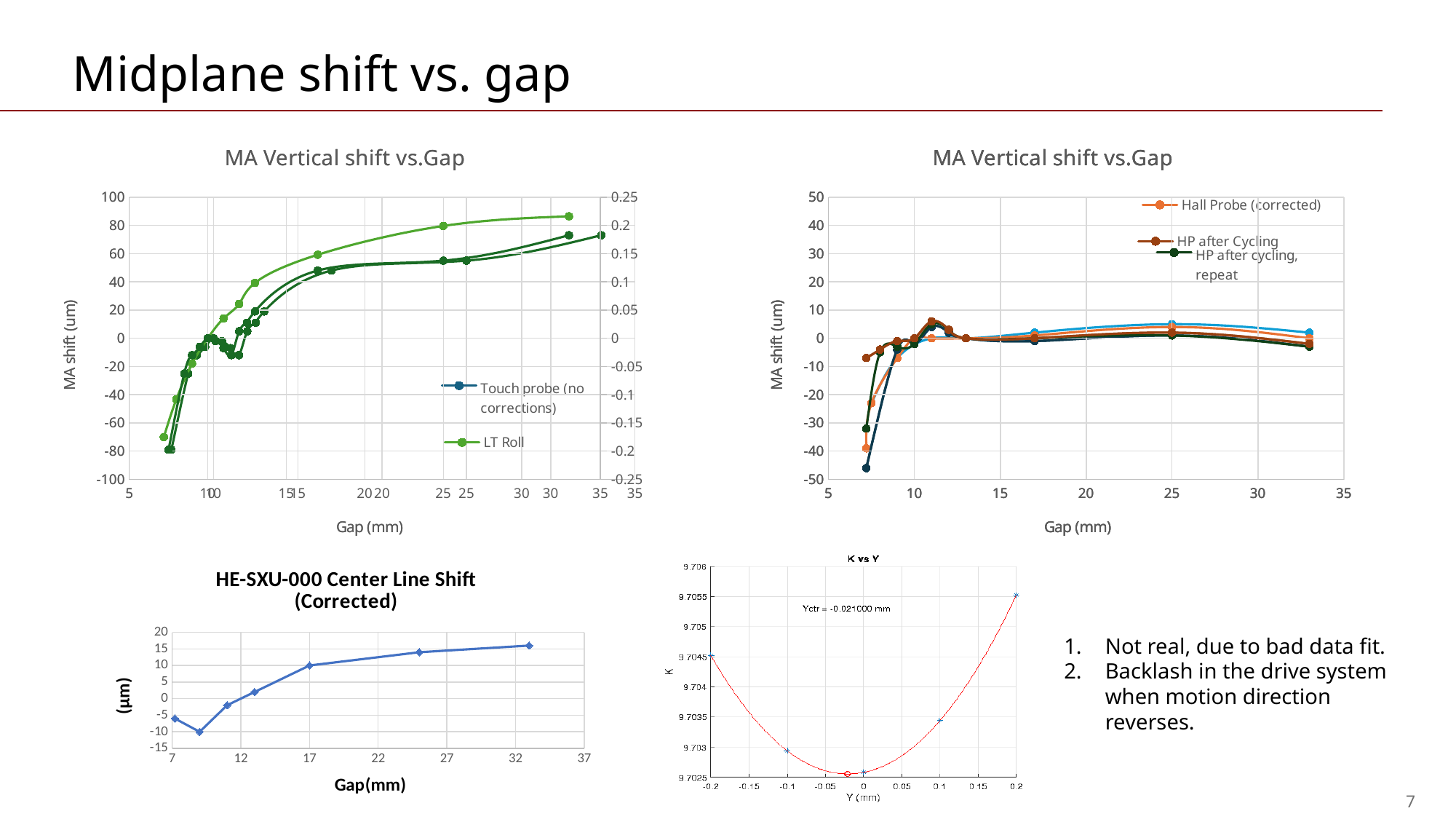
On the top-left MA Vertical shift vs.Gap chart, is the Touch probe (no corrections) value at a gap of 35 mm greater or less than 60 on the left axis? greater What is the Yctr value printed on the K vs Y chart? -0.021000 mm Which series on the top-left MA Vertical shift vs.Gap chart is drawn in light green? LT Roll How many data points are plotted on the HE-SXU-000 Center Line Shift (Corrected) chart? 7 On the HE-SXU-000 Center Line Shift (Corrected) chart, is the value at a gap of 17 mm greater or less than 5? greater How many series does the legend of the top-left MA Vertical shift vs.Gap chart list? 2 On the HE-SXU-000 Center Line Shift (Corrected) chart, do the values generally rise or fall as the gap increases from 9 mm to 33 mm? rise How many series does the legend of the top-right MA Vertical shift vs.Gap chart list? 3 What kind of chart is the HE-SXU-000 Center Line Shift (Corrected) chart? line chart What is the x-axis label of the top-right MA Vertical shift vs.Gap chart? Gap (mm) On the HE-SXU-000 Center Line Shift (Corrected) chart, is the value at a gap of about 9 mm greater or less than -5? less